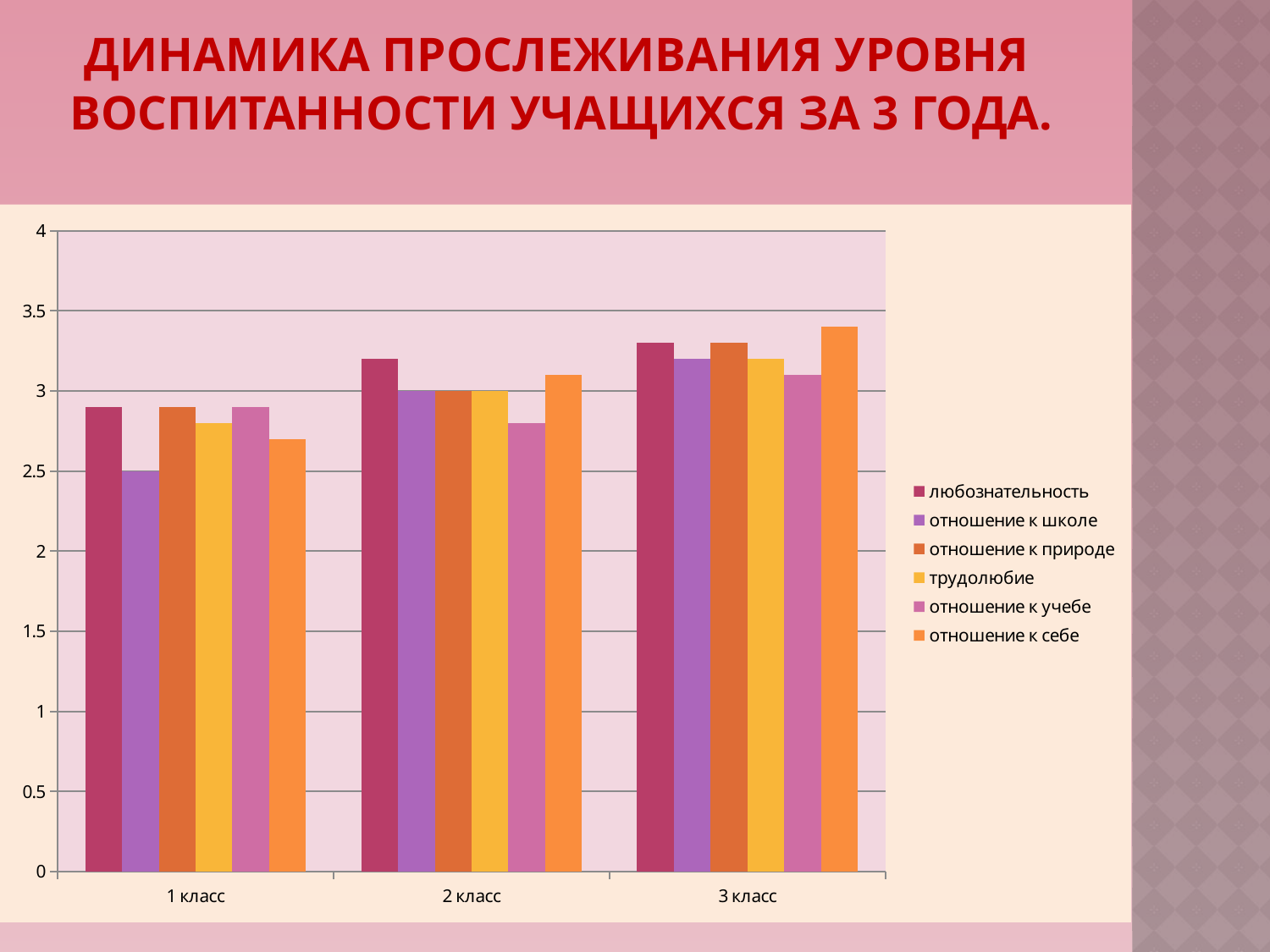
Which series has the lowest value in 1 класс? отношение к школе How many categories are shown on the x axis? 3 Which series has the highest value in 3 класс? отношение к себе What is the value for трудолюбие in 2 класс? 3 What is the value for отношение к школе in 1 класс? 2.5 What kind of chart is shown on the slide? bar chart Which is larger in 2 класс: любознательность or отношение к учебе? любознательность Is the value for любознательность in 1 класс greater or less than 2.5? greater How many series does the legend list? 6 Is the value for отношение к учебе in 2 класс greater or less than 3? less Is the value for отношение к себе in 3 класс greater or less than 3? greater Does the value for отношение к школе rise or fall from 1 класс to 3 класс? rise